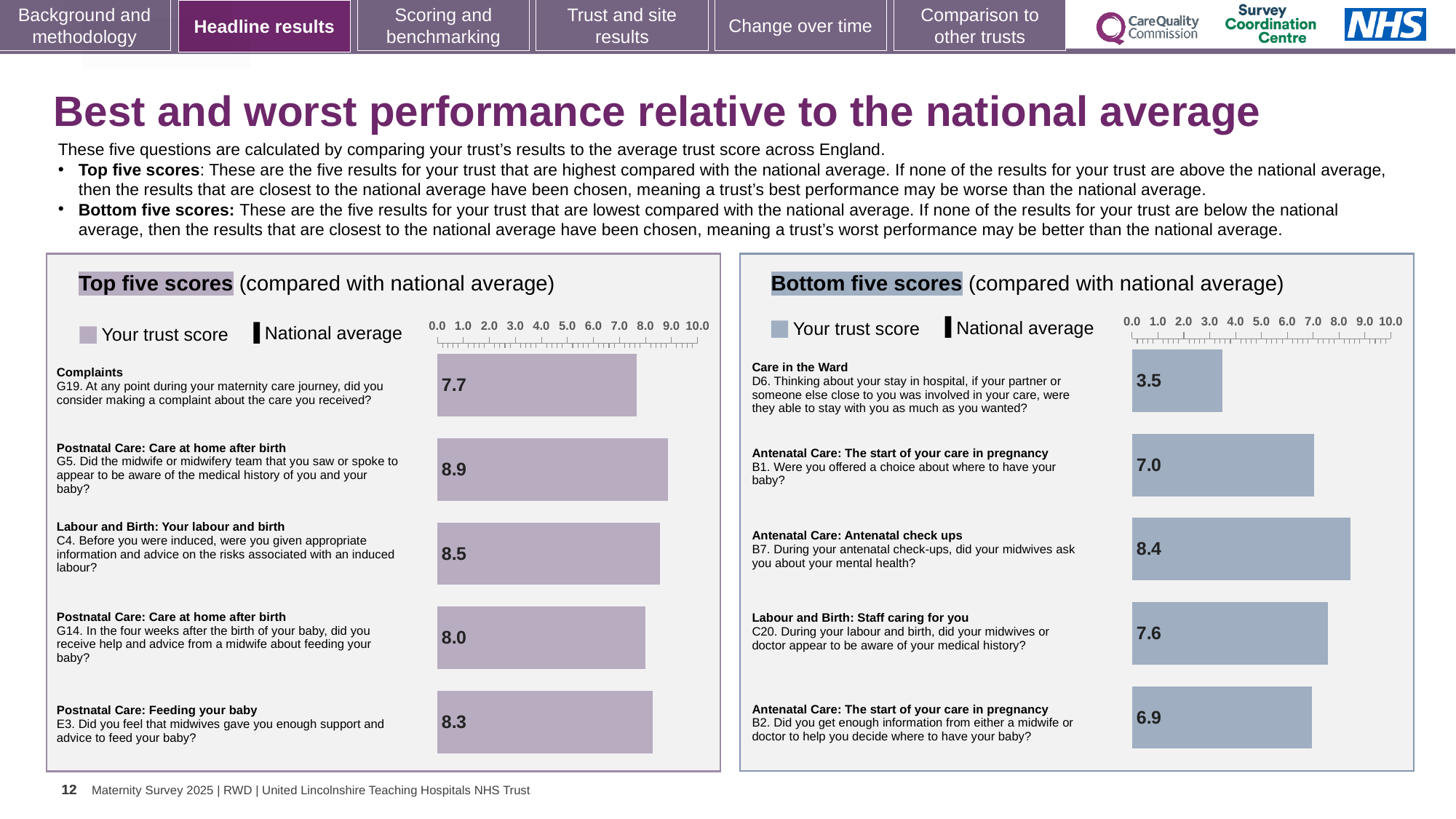
How many bars are shown in the Top five scores chart? 5 In the Bottom five scores chart, which question has the lowest trust score? D6 In the Top five scores chart, what is the difference between the trust scores for G5 and G19? 1.2 In the Bottom five scores chart, what is the trust score for D6 (Care in the Ward)? 3.5 In the Top five scores chart, what is the trust score for G19 (Complaints)? 7.7 In the Top five scores chart, which has the larger trust score, C4 or E3? C4 How many entries does the legend of the Top five scores chart list? 2 In the Bottom five scores chart, what is the difference between the trust scores for B7 and B2? 1.5 What kind of chart is the Bottom five scores chart? Bar chart In the Top five scores chart, which question has the highest trust score? G5 In the Bottom five scores chart, which question has the highest trust score? B7 In the Bottom five scores chart, is the trust score for D6 greater or less than 5.0? less